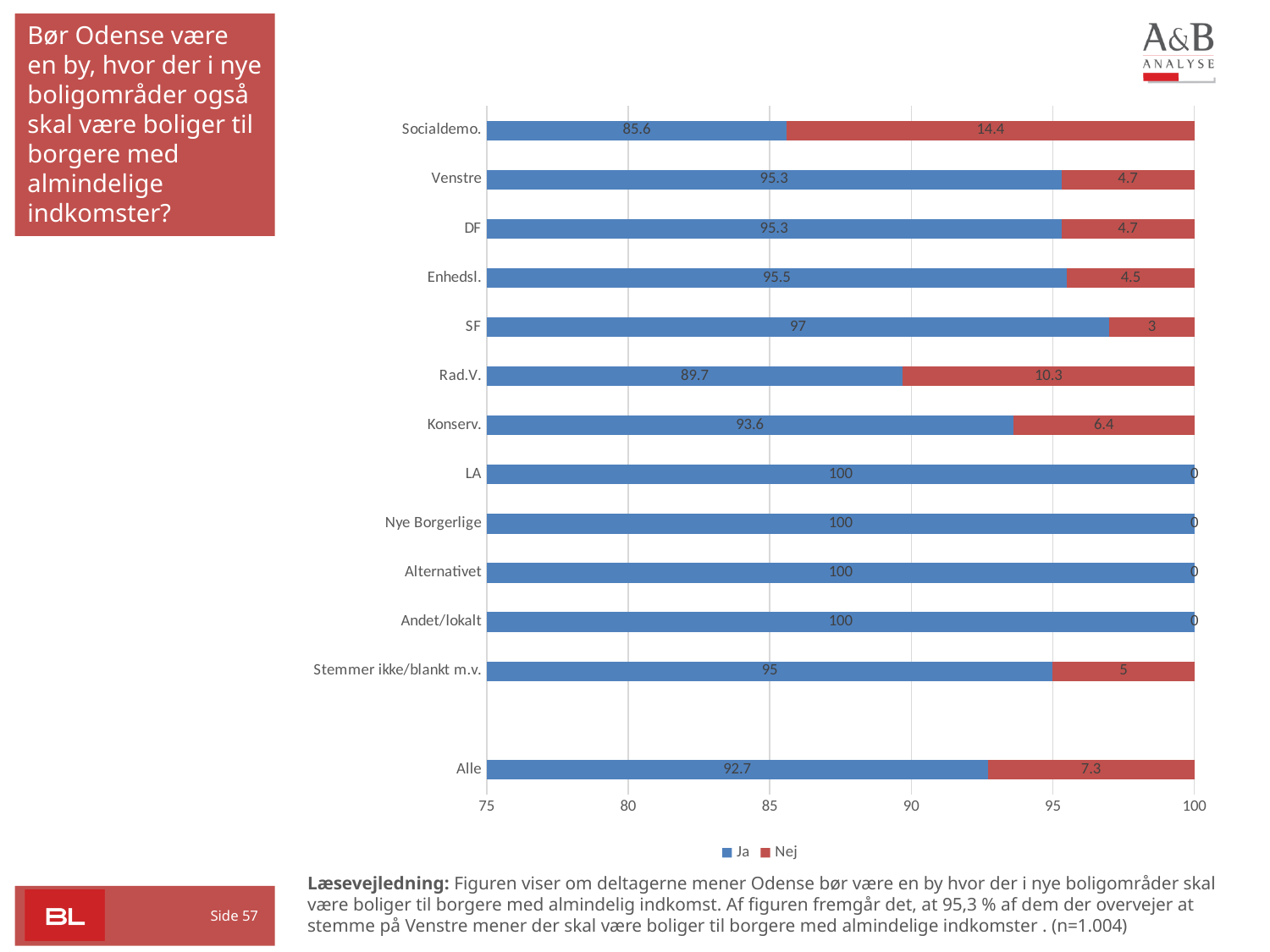
What is the "Nej" value for Socialdemo.? 14.4 Which has a larger "Ja" value, Enhedsl. or Rad.V.? Enhedsl. What kind of chart is shown on the slide? Stacked bar chart What is the total of the stacked bar for Stemmer ikke/blankt m.v.? 100 What is the difference between the "Ja" values for SF and Konserv.? 3.4 How many series does the legend list? 2 Which category has the lowest "Ja" value? Socialdemo. How many categories are shown on the y axis of the chart? 13 What is the "Ja" value for Venstre? 95.3 What is the "Nej" value for Rad.V.? 10.3 Which category has the highest "Nej" value? Socialdemo. What is the "Ja" value for Alle? 92.7